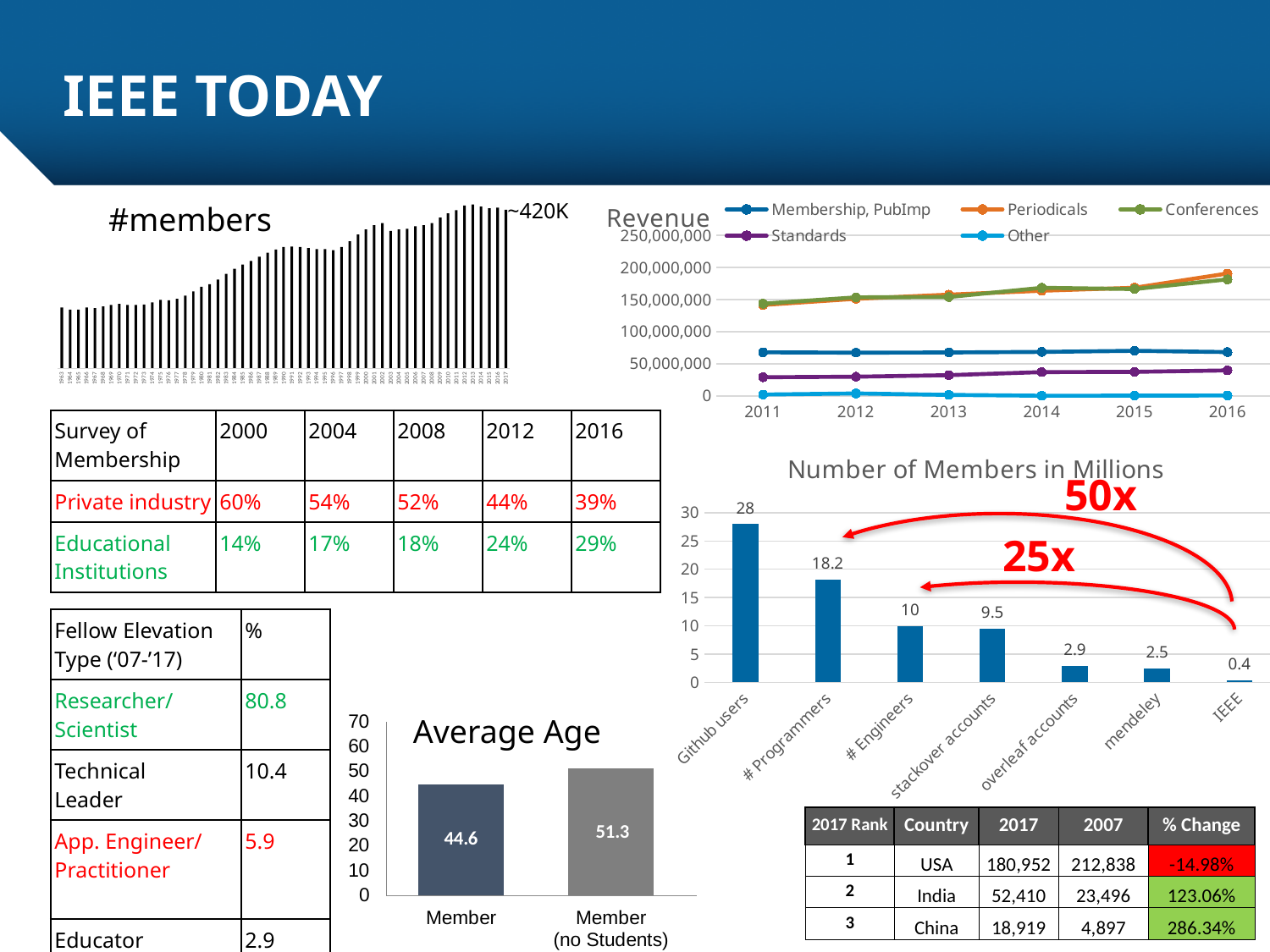
In the 'Number of Members in Millions' chart, what is the value for IEEE? 0.4 In the 'Number of Members in Millions' chart, which category has the lowest value? IEEE How many categories are shown in the 'Number of Members in Millions' chart? 7 In the 'Average Age' chart, what is the difference between Member (no Students) and Member? 6.7 In the 'Number of Members in Millions' chart, what is the difference between # Programmers and # Engineers? 8.2 In the 'Number of Members in Millions' chart, what is the value for Github users? 28 In the 'Number of Members in Millions' chart, which category has the highest value? Github users In the 'Number of Members in Millions' chart, which is larger: stackover accounts or overleaf accounts? stackover accounts What kind of chart is the 'Average Age' chart? bar chart In the 'Average Age' chart, what is the value for Member (no Students)? 51.3 In the 'Revenue' chart, is the value for Conferences in 2016 greater or less than 150,000,000? greater How many series does the legend of the 'Revenue' chart list? 5